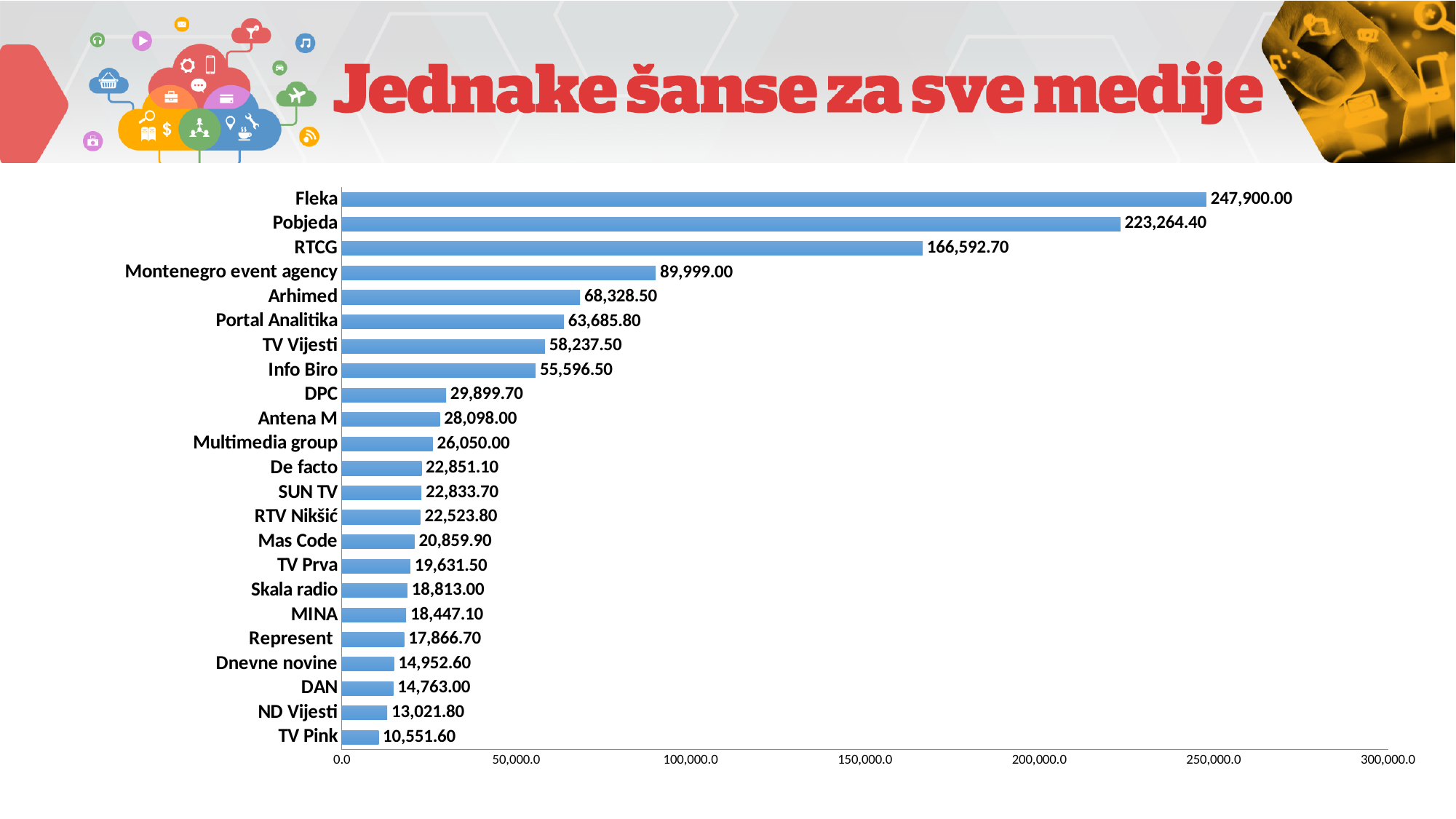
What is the difference between the values for RTCG and Montenegro event agency? 76,593.70 What is the difference between the values for Fleka and Pobjeda? 24,635.60 What is the value for Skala radio? 18,813.00 What is the title of the slide? Jednake šanse za sve medije What is the value for RTCG? 166,592.70 What is the value for Montenegro event agency? 89,999.00 What kind of chart is shown on the slide? bar chart Which has a larger value, Arhimed or Portal Analitika? Arhimed Which category has the lowest value? TV Pink Is the value for Pobjeda greater or less than 200,000.0? greater How many categories are shown in the chart? 23 Which category has the highest value? Fleka